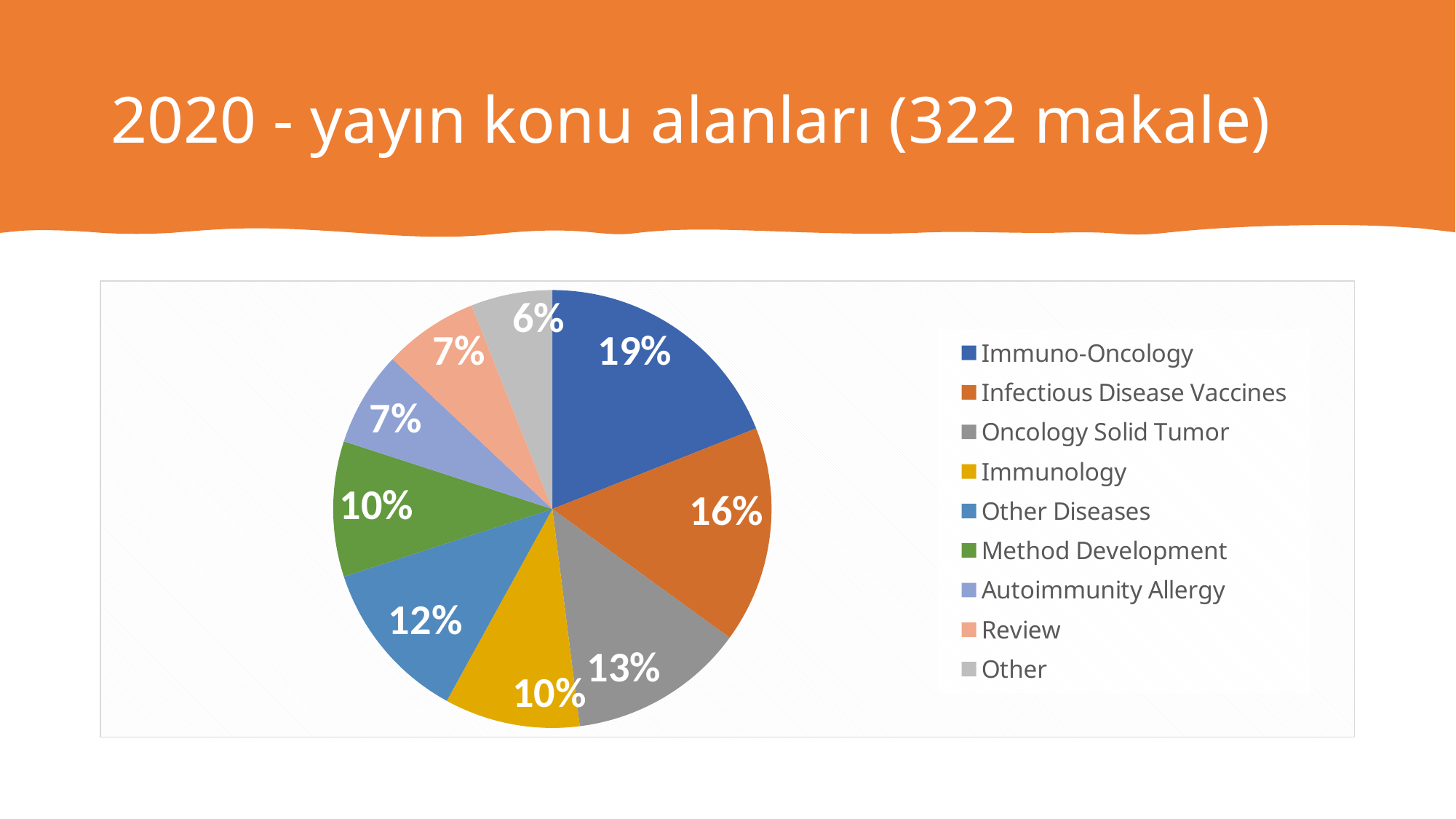
What share of the pie does Oncology Solid Tumor have? 13% What share of the pie does Method Development have? 10% What share of the pie does Other have? 6% What is the difference in percentage points between Immuno-Oncology and Infectious Disease Vaccines? 3% Which is larger, the share for Other Diseases or the share for Immunology? Other Diseases How many categories does the legend list? 9 Which category has the largest slice of the pie? Immuno-Oncology What kind of chart is shown on the slide? pie chart Which category has the smallest slice of the pie? Other